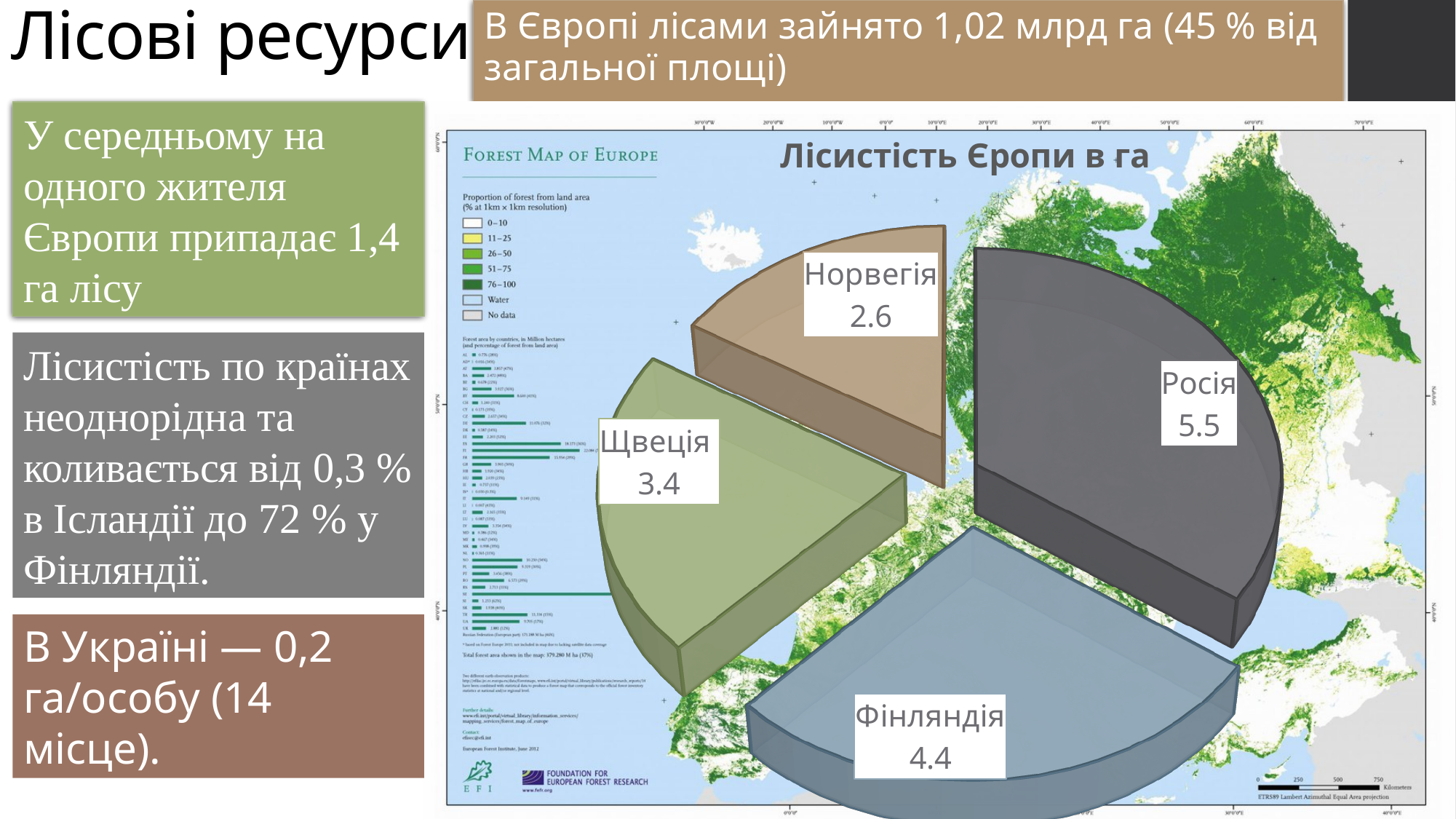
What is the title of the pie chart? Лісистість Єропи в га What is the value shown for Фінляндія in the pie chart? 4.4 What is the value shown for Росія in the pie chart? 5.5 What type of chart is shown on the slide? pie chart How many slices does the pie chart have? 4 What is the value shown for Норвегія in the pie chart? 2.6 What is the total of all four values in the pie chart? 15.9 Which country has the smallest slice in the pie chart? Норвегія What is the value shown for Щвеція in the pie chart? 3.4 What is the difference between the values for Росія and Норвегія? 2.9 Which has a larger value, Фінляндія or Щвеція? Фінляндія Which country has the largest slice in the pie chart? Росія